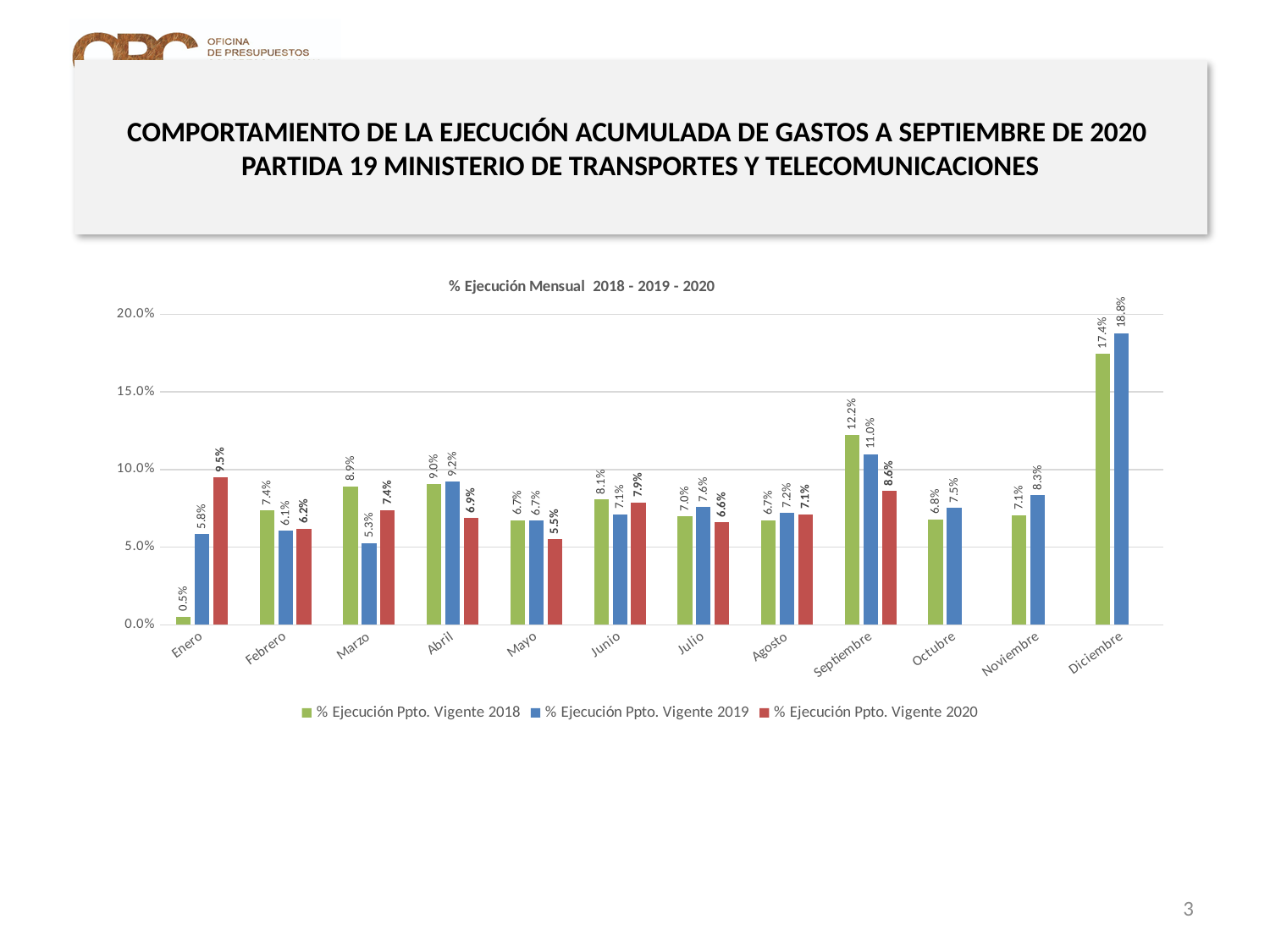
Which month has the lowest value for % Ejecución Ppto. Vigente 2018? Enero How many months are shown on the x axis? 12 What is the value for % Ejecución Ppto. Vigente 2019 in Diciembre? 18.8% What is the title of the chart? % Ejecución Mensual 2018 - 2019 - 2020 Is the value for % Ejecución Ppto. Vigente 2019 in Septiembre greater or less than 10.0%? greater What is the value for % Ejecución Ppto. Vigente 2020 in Enero? 9.5% What kind of chart is shown on the slide? Bar chart Which month has the highest value for % Ejecución Ppto. Vigente 2020? Enero What is the value for % Ejecución Ppto. Vigente 2018 in Septiembre? 12.2% In Marzo, which is larger: the 2018 value or the 2019 value? 2018 How many series does the legend list? 3 What is the difference between the 2018 and 2019 values in Diciembre? 1.4%